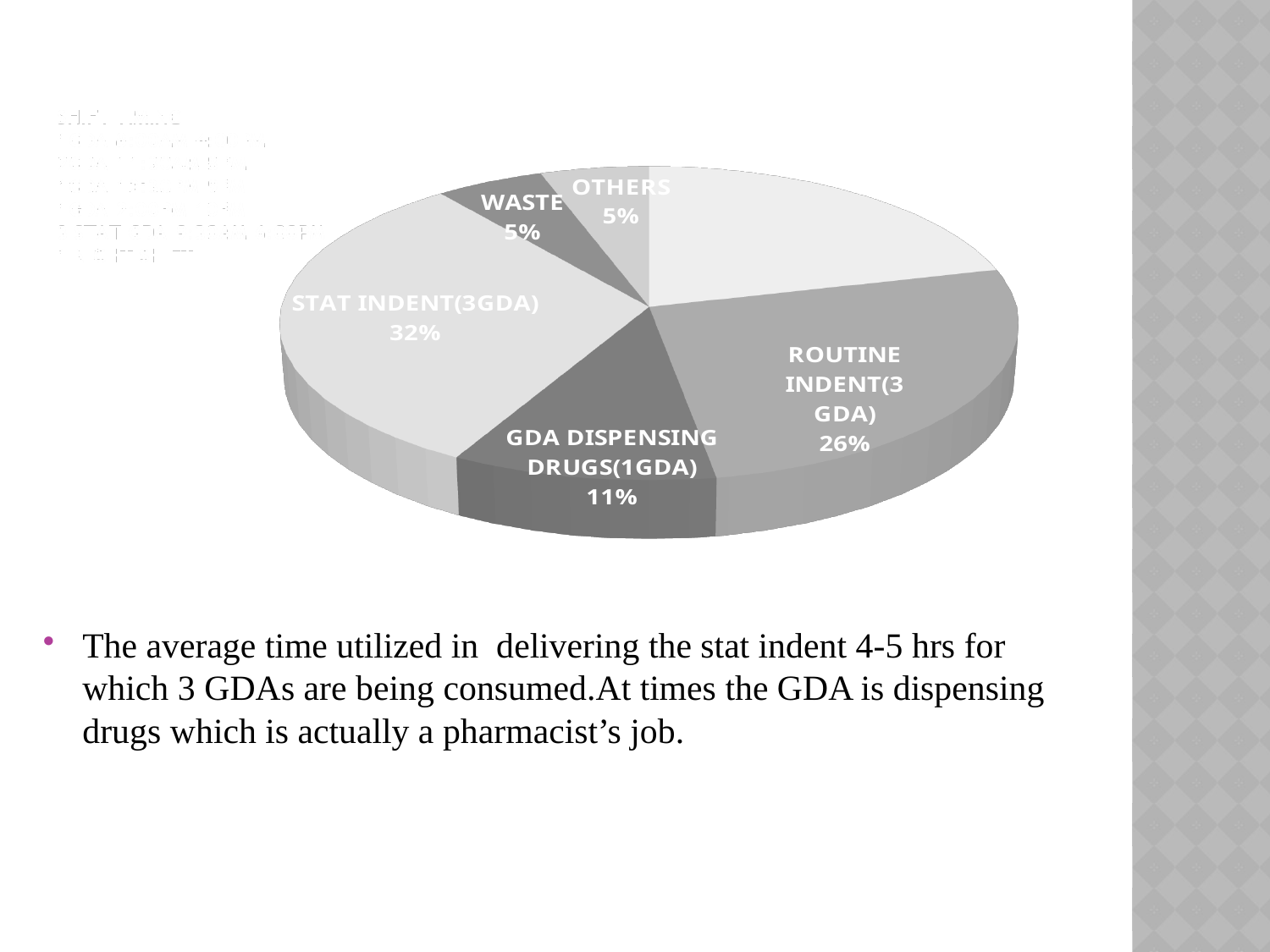
What percentage is shown for WASTE in the pie chart? 5% What share of the pie chart is GDA DISPENSING DRUGS(1GDA)? 11% What type of chart is shown on the slide? Pie chart Which is larger in the pie chart, GDA DISPENSING DRUGS(1GDA) or WASTE? GDA DISPENSING DRUGS(1GDA) Do WASTE and OTHERS have the same percentage in the pie chart? Yes What percentage is shown for OTHERS in the pie chart? 5% What is the difference in percentage points between STAT INDENT(3GDA) and ROUTINE INDENT(3 GDA)? 6% Which labeled slice of the pie chart has the largest percentage? STAT INDENT(3GDA) What percentage does ROUTINE INDENT(3 GDA) account for in the pie chart? 26% What is the difference in percentage points between ROUTINE INDENT(3 GDA) and GDA DISPENSING DRUGS(1GDA)? 15% What percentage of the pie chart is STAT INDENT(3GDA)? 32% Which is larger in the pie chart, STAT INDENT(3GDA) or ROUTINE INDENT(3 GDA)? STAT INDENT(3GDA)